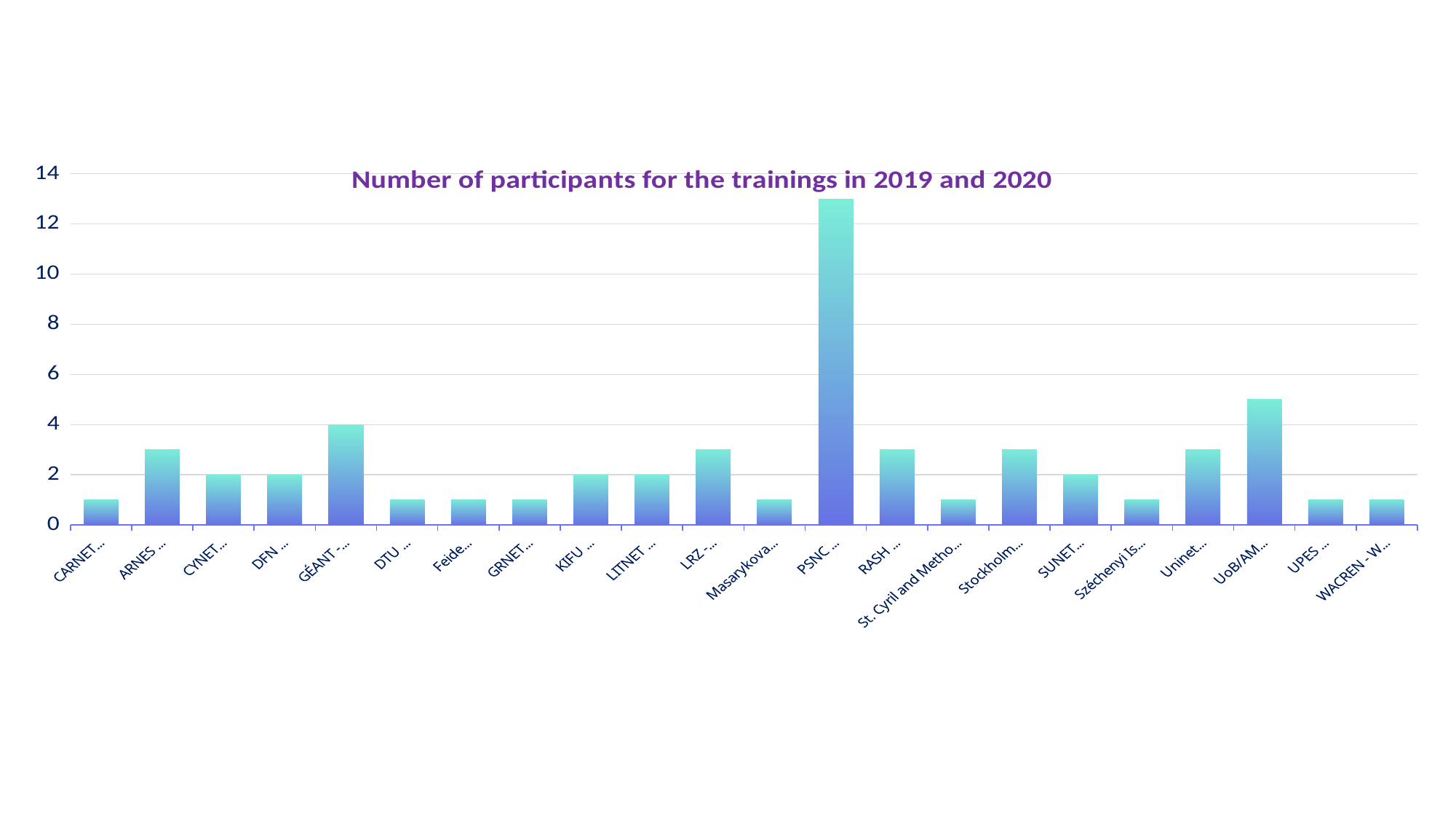
What is the title of the chart? Number of participants for the trainings in 2019 and 2020 What is the value for GÉANT? 4 What is the value for SUNET? 2 What is the value for CYNET? 2 How many categories are shown on the x axis? 22 Is the value for PSNC greater or less than 12? greater Which category has the highest number of participants? PSNC Is the value for CARNET greater or less than 2? less What kind of chart is shown on the slide? bar chart What is the difference between the values for GÉANT and KIFU? 2 Is the value for UoB/AM greater or less than 4? greater Which is larger, the value for GÉANT or the value for DFN? GÉANT